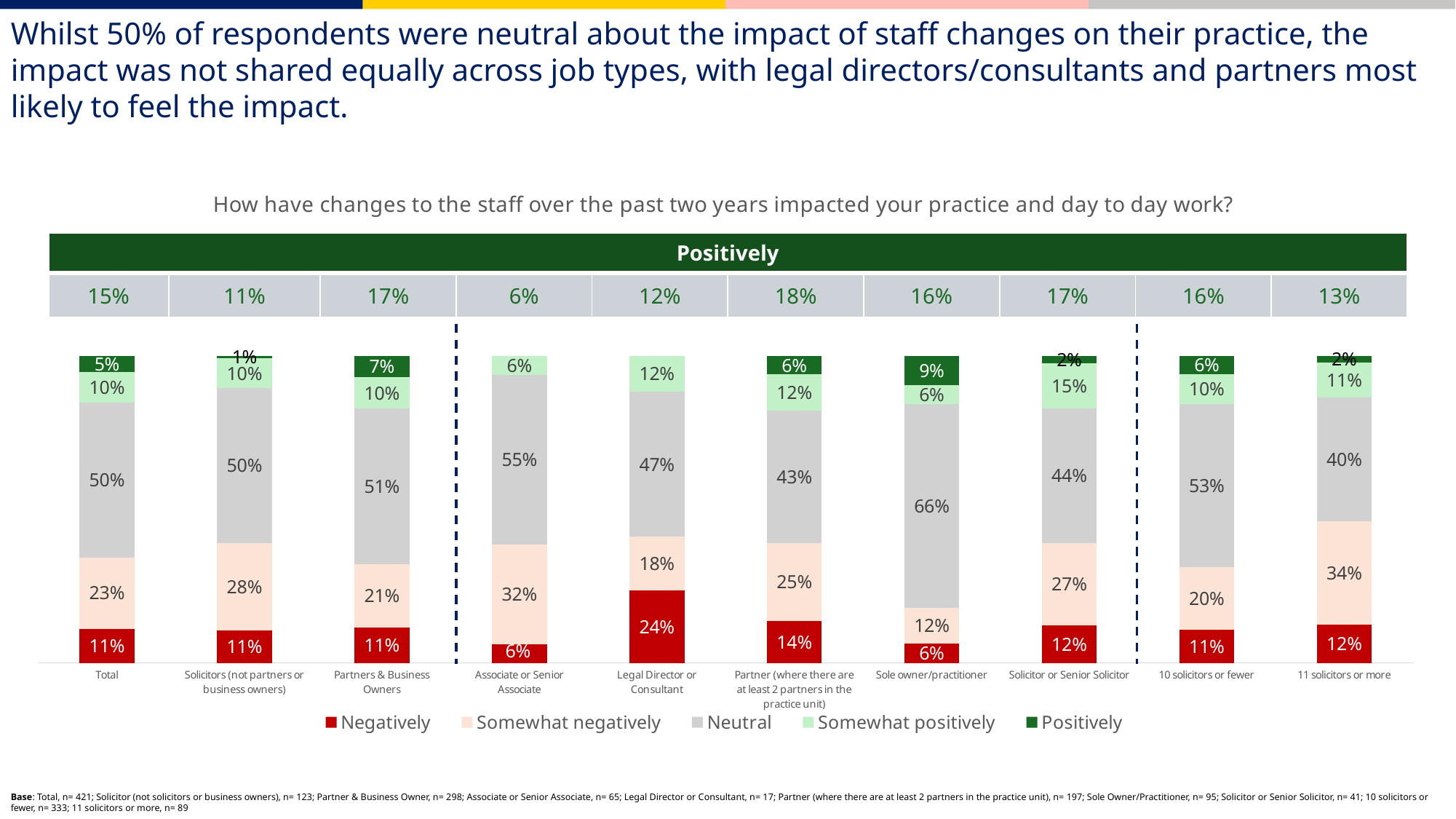
Which category has the highest Negatively value? Legal Director or Consultant Which has the larger Neutral value, Associate or Senior Associate or Legal Director or Consultant? Associate or Senior Associate What kind of chart is this? Stacked bar chart What is the Neutral value for Sole owner/practitioner? 66% Which category has the lowest Neutral value? 11 solicitors or more How many series does the legend list? 5 How many categories are shown on the x axis? 10 What is the difference between the Somewhat negatively values for 11 solicitors or more and 10 solicitors or fewer? 14 percentage points Which category has the highest Neutral value? Sole owner/practitioner What colour represents the Negatively series in the legend? Red In the Positively summary row above the chart, what is the value for Partner (where there are at least 2 partners in the practice unit)? 18% What is the Negatively value for Legal Director or Consultant? 24%